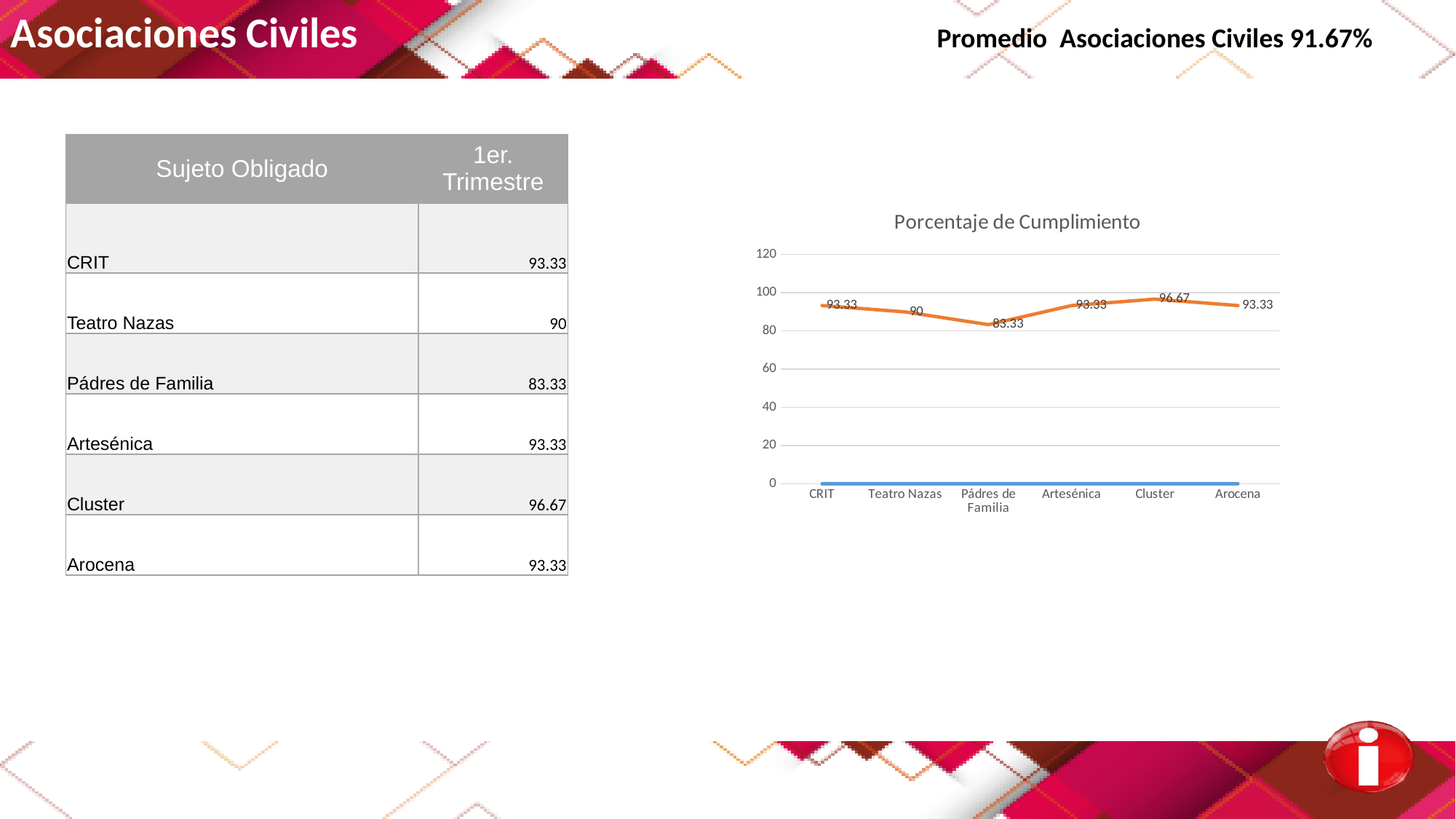
Which category has the highest value in the chart? Cluster Which is larger, the value for Teatro Nazas or the value for Arocena? Arocena What type of chart is shown on the slide? line chart What is the value for Pádres de Familia in the chart? 83.33 What is the value for Cluster in the chart? 96.67 What is the difference between the values for Cluster and Pádres de Familia? 13.34 How many categories are plotted along the x axis of the chart? 6 Which category has the lowest value in the chart? Pádres de Familia What is the value for CRIT in the chart? 93.33 What is the title of the chart? Porcentaje de Cumplimiento What is the value for Teatro Nazas in the chart? 90 Is the value for Pádres de Familia greater or less than 100? less